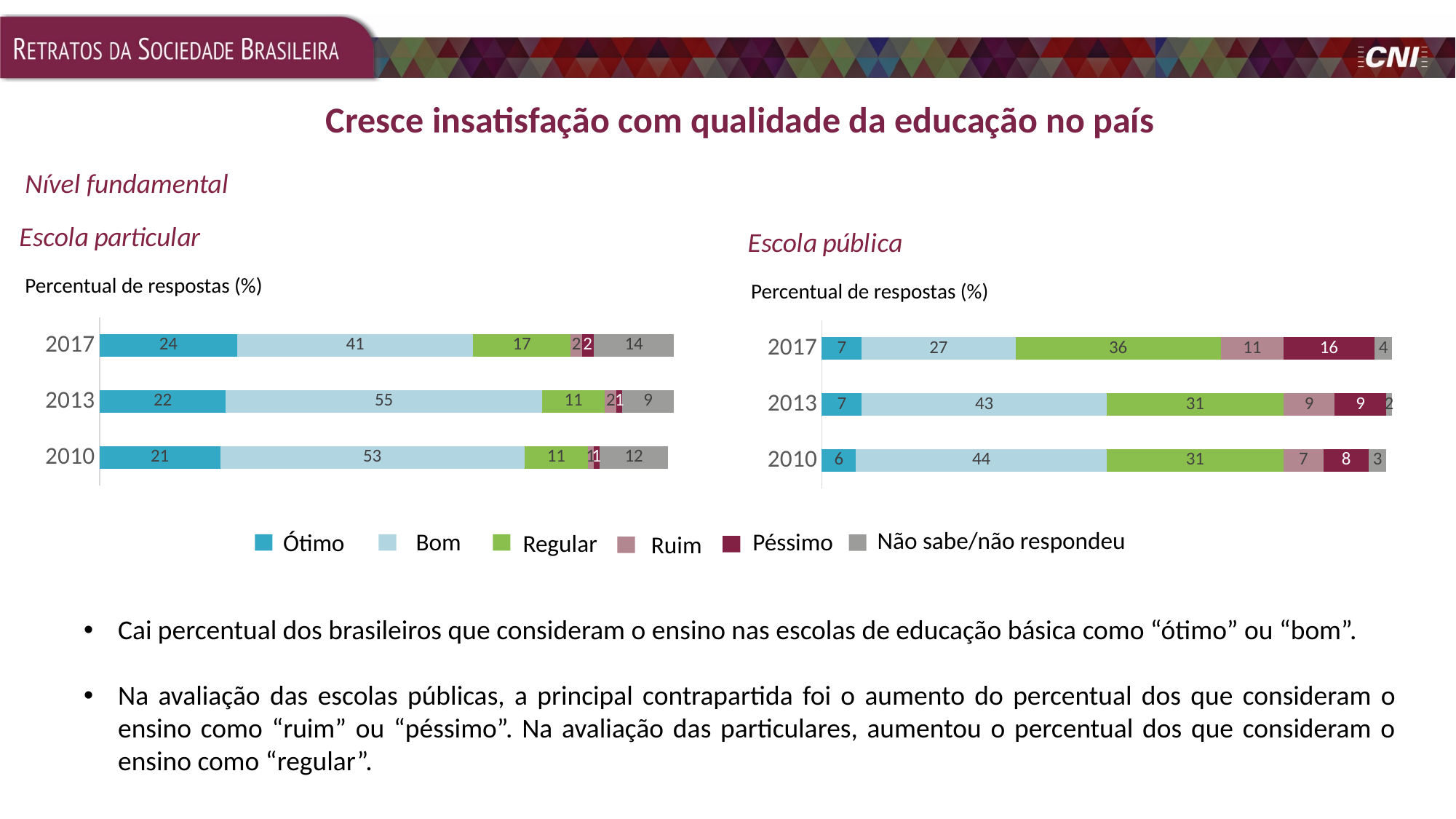
In the Escola pública chart, what is the difference between the "Bom" values for 2013 and 2017? 16 In the Escola pública chart, what percentage of responses in 2017 were "Péssimo"? 16 In the Escola particular chart, what is the "Regular" value for 2013? 11 In the Escola pública chart, which year has the highest "Regular" value? 2017 How many series does the legend list? 6 How many years are shown in the Escola pública chart? 3 In the Escola pública chart, what percentage of responses in 2010 were "Bom"? 44 What kind of chart is the Escola particular chart? Stacked bar chart In the Escola particular chart, which year has the lowest "Não sabe/não respondeu" value? 2013 In the Escola pública chart, what is the total of the 2017 stacked bar? 101 In the Escola particular chart, is the "Ótimo" value larger in 2017 or in 2010? 2017 In the Escola particular chart, what percentage of responses in 2017 were "Bom"? 41